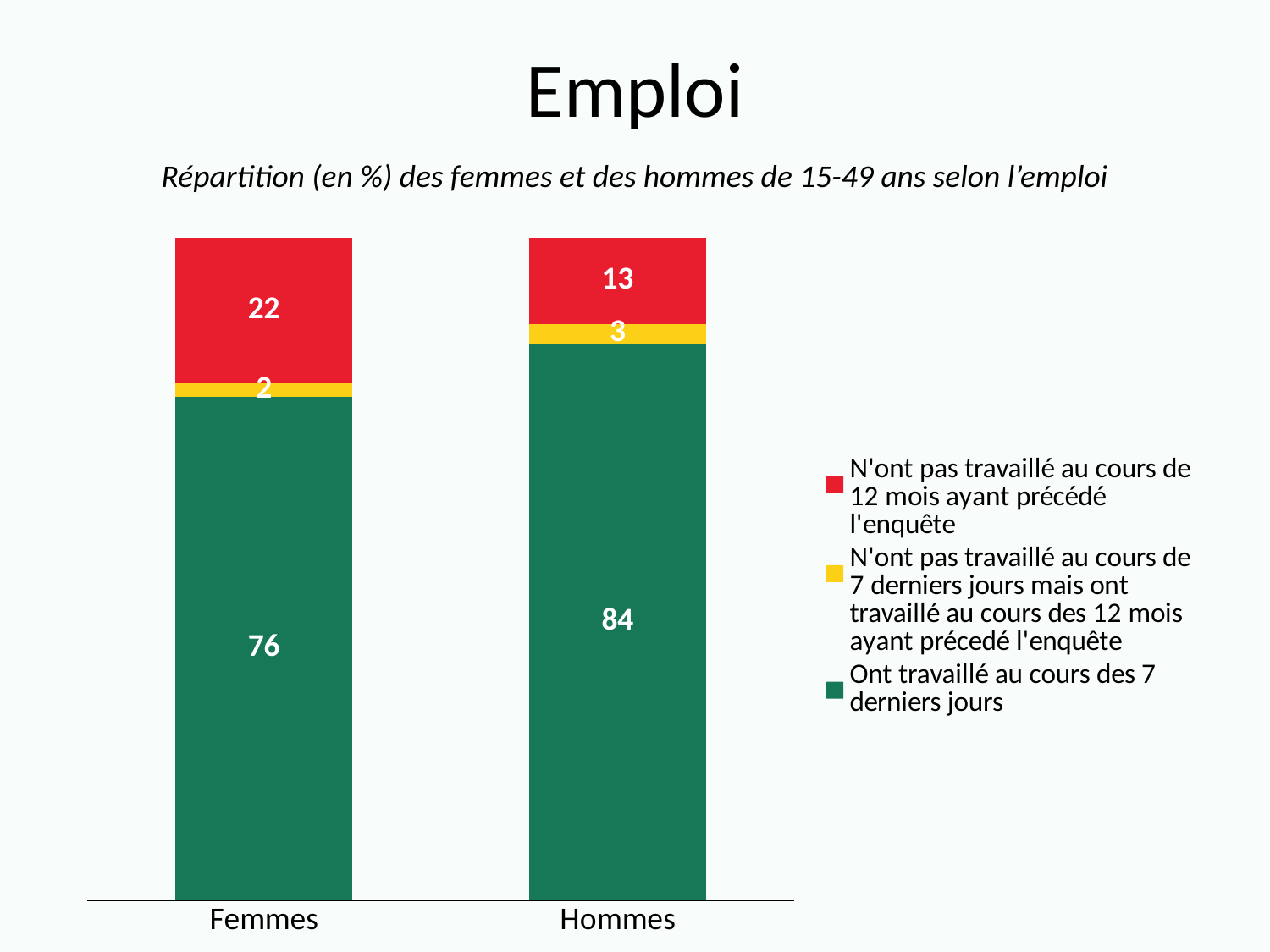
What is the value of the yellow segment for Hommes? 3 What percentage of women (Femmes) worked in the last 7 days (Ont travaillé au cours des 7 derniers jours)? 76 How many series does the legend list? 3 What kind of chart is shown on the slide? Stacked bar chart What is the difference between the Hommes and Femmes values for 'Ont travaillé au cours des 7 derniers jours'? 8 Which category has the higher value for 'N'ont pas travaillé au cours de 12 mois ayant précédé l'enquête'? Femmes What percentage of men (Hommes) did not work in the 12 months preceding the survey? 13 What is the difference between the Femmes and Hommes values for the red segment? 9 Which category has the higher value for 'Ont travaillé au cours des 7 derniers jours', Femmes or Hommes? Hommes How many categories are shown on the x axis? 2 What is the value of the red segment for Femmes? 22 What is the total of the stacked bar for Femmes? 100